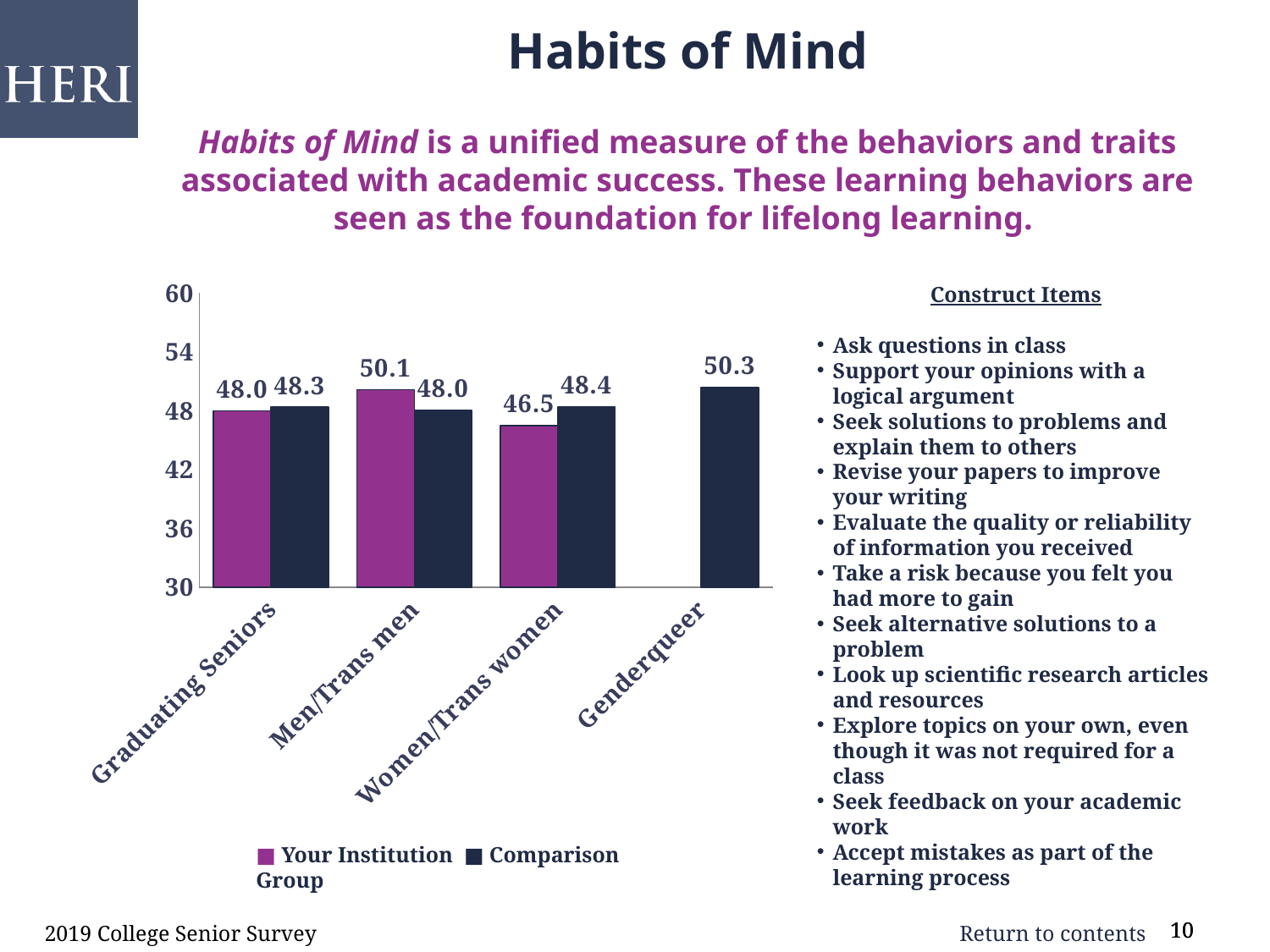
Which category has the highest Comparison Group value? Genderqueer What is the Your Institution value for Men/Trans men? 50.1 Which category has the lowest Your Institution value? Women/Trans women What is the difference between the Your Institution and Comparison Group values for Women/Trans women? 1.9 Is the Comparison Group value for Genderqueer greater or less than 48? greater For Men/Trans men, which is larger: the Your Institution value or the Comparison Group value? Your Institution How many series does the chart legend list? 2 What is the Comparison Group value for Genderqueer? 50.3 What is the Comparison Group value for Women/Trans women? 48.4 What is the Your Institution value for Graduating Seniors? 48.0 How many categories are shown on the x axis of the chart? 4 What kind of chart is shown on the slide? Bar chart